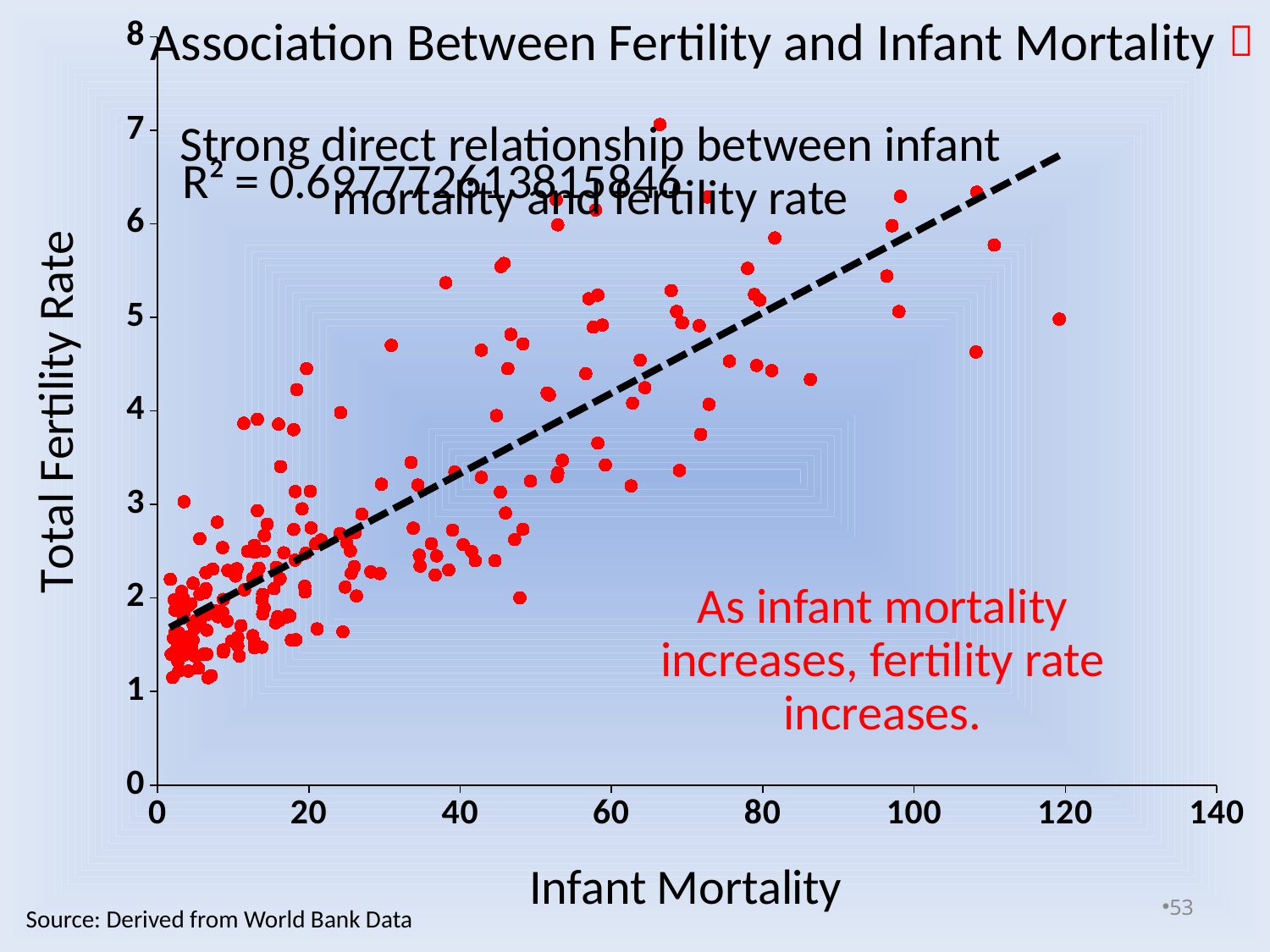
What kind of chart is shown on the slide? scatter plot What is the R² value printed on the chart? 0.697772613815846 Is the dashed trendline's value at an infant mortality of 120 greater or less than 5? greater What is the title of the chart? Association Between Fertility and Infant Mortality What is the highest tick value shown on the y axis? 8 Is the highest plotted point on the chart greater or less than 6 on the y axis? greater What is the highest tick value shown on the x axis? 140 Is the dashed trendline's value at an infant mortality of 20 greater or less than 3? less What variable is plotted on the x axis? Infant Mortality As infant mortality increases along the x axis, does the total fertility rate tend to rise or fall? rise